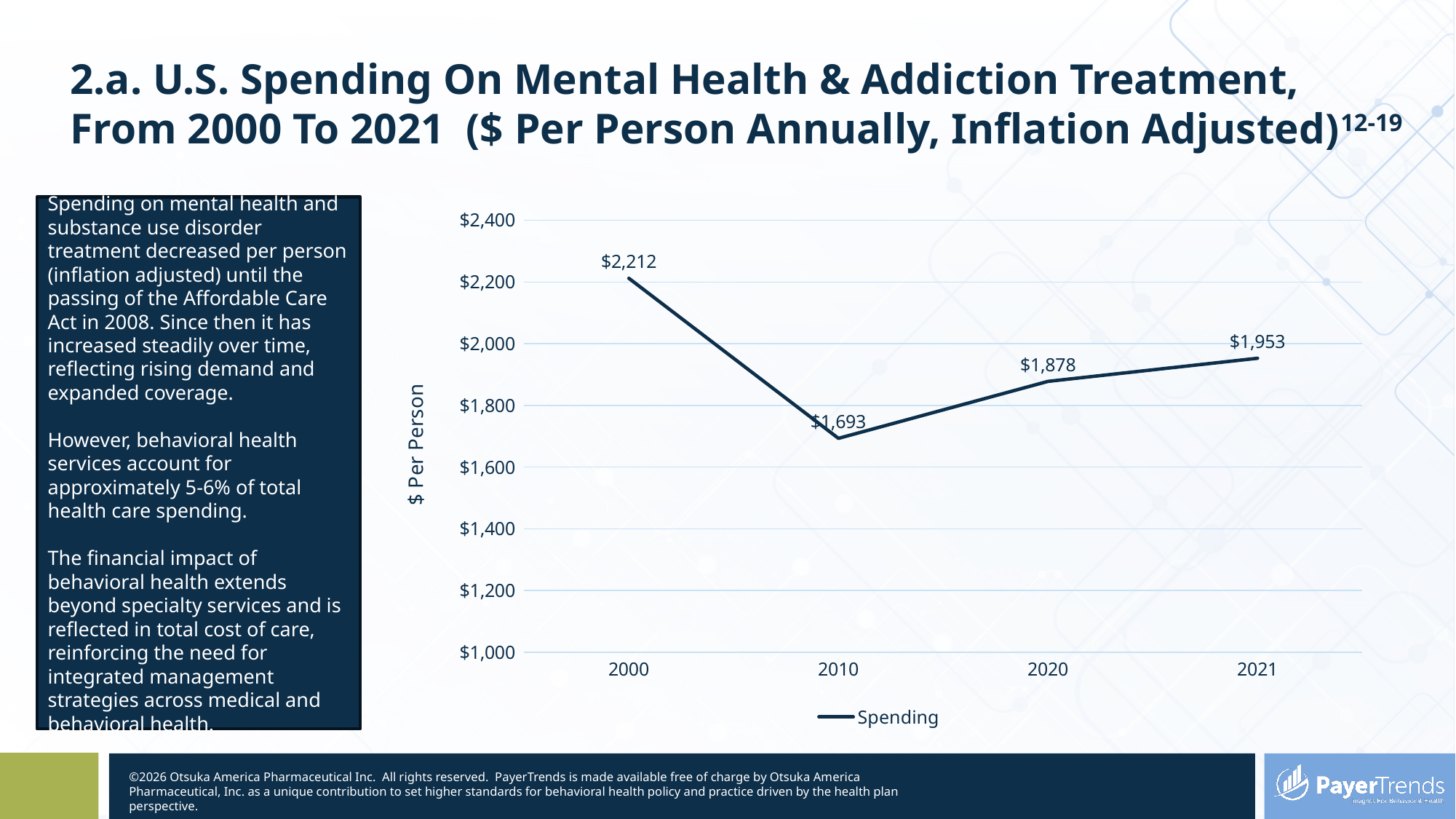
What is the difference in spending per person between 2021 and 2020? $75 How many years are plotted on the chart? 4 Which year has higher spending per person, 2010 or 2020? 2020 What is the difference in spending per person between 2000 and 2010? $519 What is the spending per person in 2021? $1,953 What is the label on the y axis of the chart? $ Per Person What is the spending per person in 2000? $2,212 Which year has the highest spending per person? 2000 Which year has the lowest spending per person? 2010 What is the spending per person in 2010? $1,693 What is the spending per person in 2020? $1,878 What kind of chart is shown on the slide? Line chart